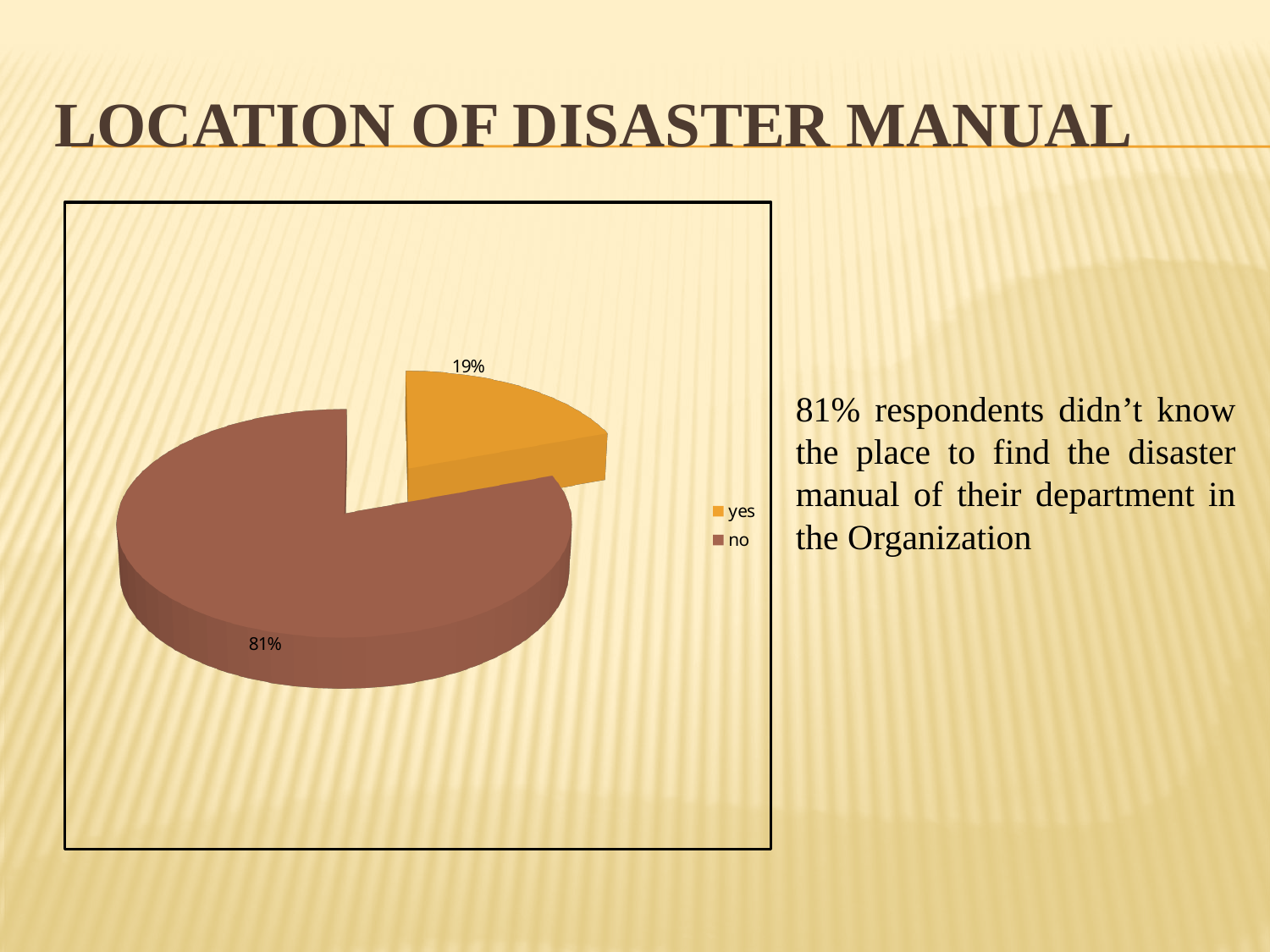
What percentage of the pie is labelled "no"? 81% Which is larger, the "yes" slice or the "no" slice? no How many entries does the legend list? 2 What kind of chart is shown on the slide? pie chart How many slices does the pie chart have? 2 What share of the pie does the "no" slice take? 81% Which slice of the pie is the smallest? yes What percentage of the pie is labelled "yes"? 19% What is the difference in percentage points between the "no" slice and the "yes" slice? 62 What colour is the "yes" slice in the pie chart? orange What is the title of the slide containing the pie chart? LOCATION OF DISASTER MANUAL Which slice of the pie is the largest? no